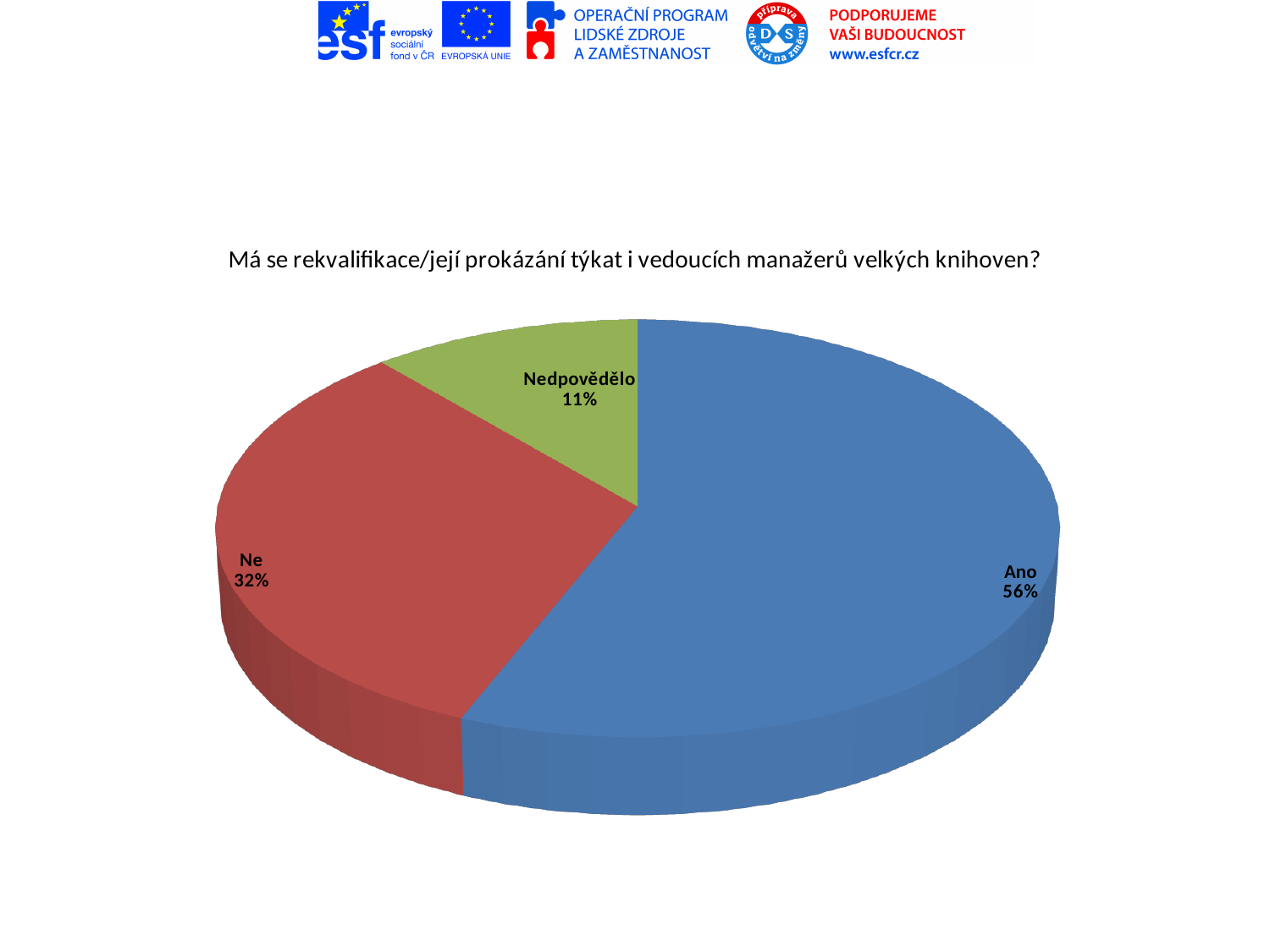
What is the difference in percentage points between the "Ano" and "Ne" slices? 24 What share of the pie does the "Ano" slice represent? 56% What share of the pie does the "Ne" slice represent? 32% Which slice is larger, "Ne" or "Nedpovědělo"? Ne What share of the pie does the "Nedpovědělo" slice represent? 11% Which slice of the pie is the smallest? Nedpovědělo Which slice of the pie is the largest? Ano How many slices does the pie chart have? 3 What colour is the "Ano" slice? blue What is the difference in percentage points between the "Ne" and "Nedpovědělo" slices? 21 What type of chart is shown on the slide? pie chart What is the title of the chart? Má se rekvalifikace/její prokázání týkat i vedoucích manažerů velkých knihoven?